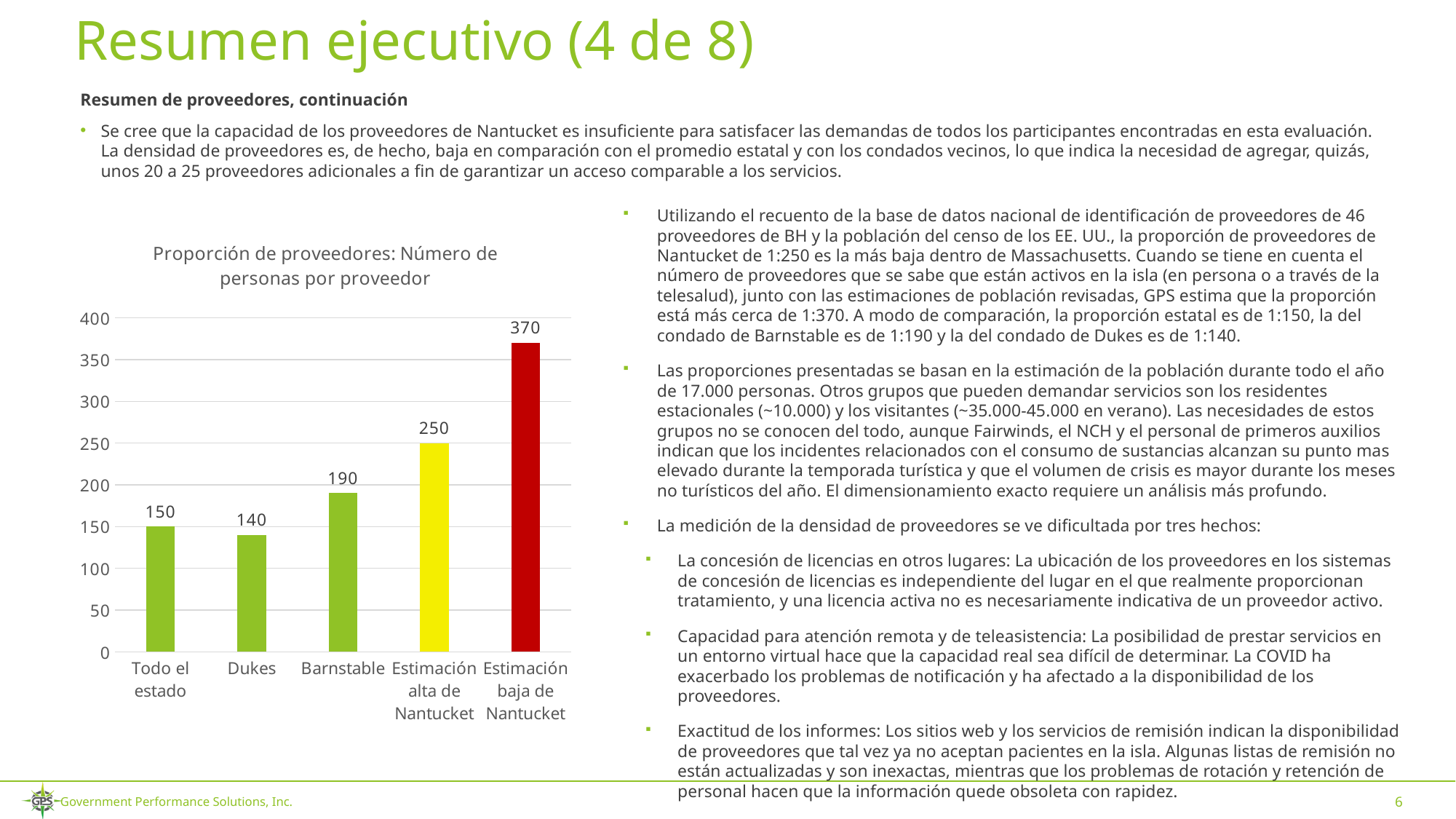
Which category has the highest value? Estimación baja de Nantucket What is the value for Dukes? 140 What is the difference between Estimación baja de Nantucket and Estimación alta de Nantucket? 120 What kind of chart is shown? Bar chart Is the value for Estimación alta de Nantucket greater or less than 200? greater Which category has the lowest value? Dukes What is the value for Estimación baja de Nantucket? 370 Which is larger, Barnstable or Todo el estado? Barnstable How many categories are shown on the x axis? 5 What is the value for Barnstable? 190 What is the difference between Todo el estado and Dukes? 10 What is the title of the chart? Proporción de proveedores: Número de personas por proveedor